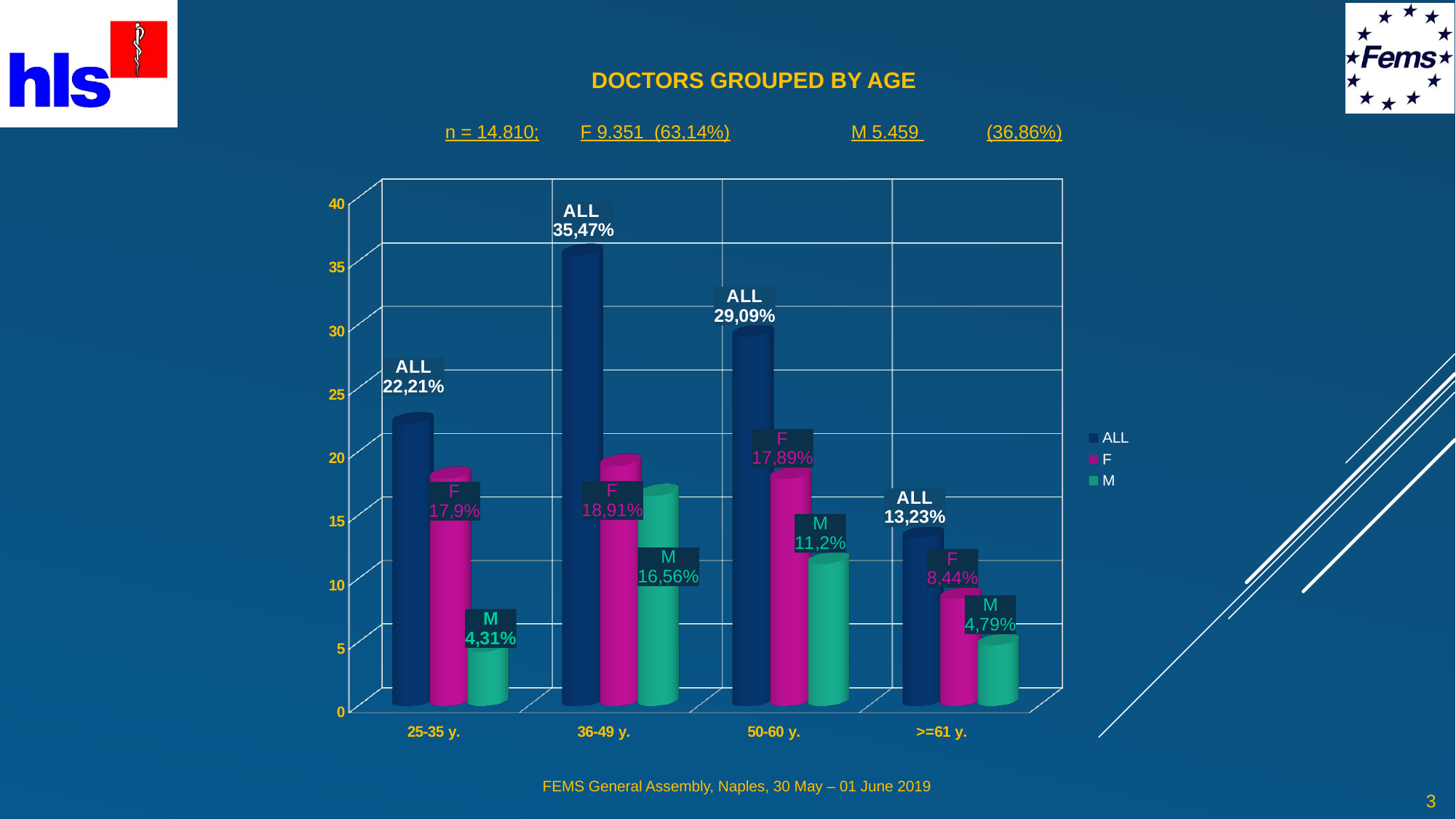
What is the difference between the ALL values for 36-49 y. and 50-60 y.? 6,38% What is the F value for the 50-60 y. age group? 17,89% What kind of chart is shown on the slide? bar chart What is the ALL value for the 36-49 y. age group? 35,47% What is the M value for the 25-35 y. age group? 4,31% How many series does the legend list? 3 What is the title of the chart? DOCTORS GROUPED BY AGE Which age group has the lowest M value? 25-35 y. How many age groups are shown on the x axis? 4 Which is larger, the M value for 36-49 y. or the M value for 50-60 y.? 36-49 y. What is the F value for the >=61 y. age group? 8,44% Which age group has the highest ALL value? 36-49 y.